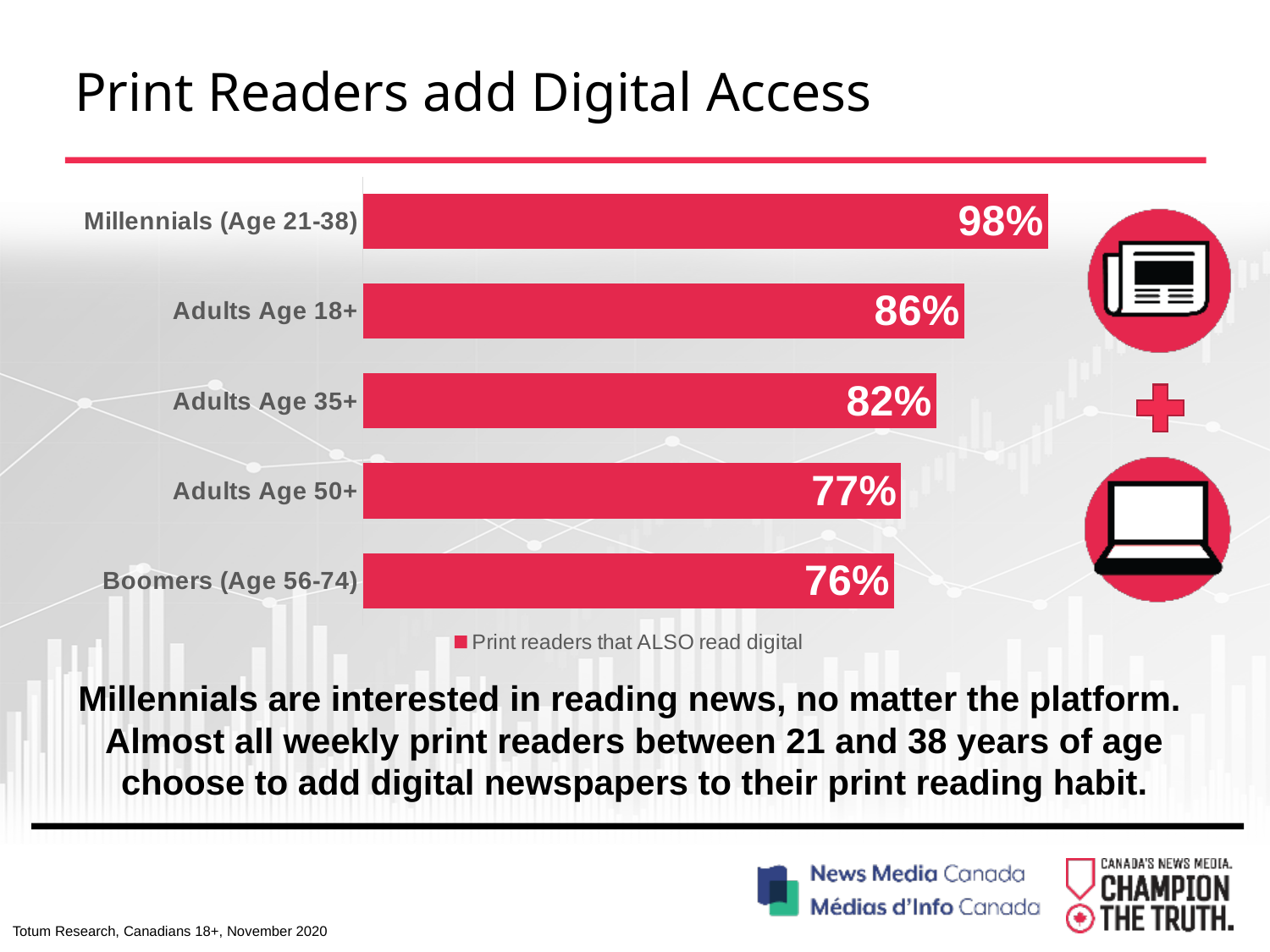
What is the difference between the values for Adults Age 18+ and Adults Age 50+? 9% What kind of chart is shown on the slide? Bar chart What is the value shown for Adults Age 35+? 82% How many categories are shown in the chart? 5 What percentage of Millennials (Age 21-38) print readers also read digital? 98% Which category has the lowest value? Boomers (Age 56-74) What is the value shown for Boomers (Age 56-74)? 76% What is the value shown for Adults Age 18+? 86% What is the difference between the values for Millennials (Age 21-38) and Boomers (Age 56-74)? 22% Which category has the highest value? Millennials (Age 21-38) Which is larger, the value for Adults Age 35+ or the value for Adults Age 50+? Adults Age 35+ What is the legend entry for the series shown in the chart? Print readers that ALSO read digital